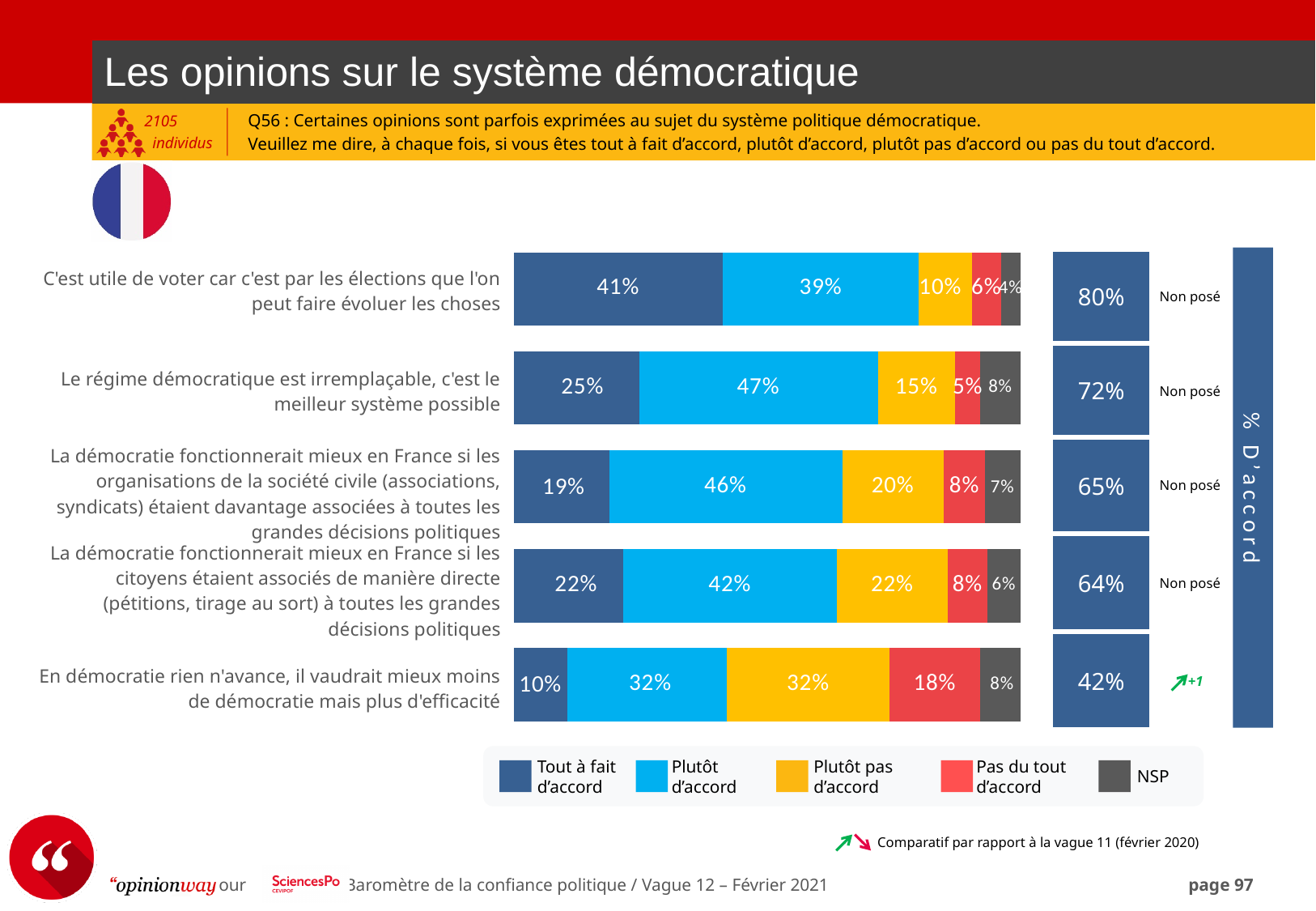
What is the combined 'Tout à fait d'accord' plus 'Plutôt d'accord' total for 'La démocratie fonctionnerait mieux en France si les organisations de la société civile...'? 65% What kind of chart is shown on the slide? Stacked bar chart How many statements (categories) are plotted in the chart? 5 Which statement has the highest '% D'accord' value? C'est utile de voter car c'est par les élections que l'on peut faire évoluer les choses What is the 'Plutôt d'accord' value for 'Le régime démocratique est irremplaçable, c'est le meilleur système possible'? 47% How many series does the legend list? 5 Which legend entry is shown in red? Pas du tout d'accord What is the 'Pas du tout d'accord' value for 'En démocratie rien n'avance, il vaudrait mieux moins de démocratie mais plus d'efficacité'? 18% What is the difference between the '% D'accord' values for 'C'est utile de voter...' (80%) and 'Le régime démocratique est irremplaçable...' (72%)? 8 points Which statement has the lowest 'Tout à fait d'accord' value? En démocratie rien n'avance, il vaudrait mieux moins de démocratie mais plus d'efficacité Which is larger: the 'Plutôt pas d'accord' value for 'La démocratie fonctionnerait mieux en France si les citoyens étaient associés de manière directe...' or for 'Le régime démocratique est irremplaçable...'? La démocratie fonctionnerait mieux en France si les citoyens étaient associés de manière directe... What is the 'Tout à fait d'accord' value for 'C'est utile de voter car c'est par les élections que l'on peut faire évoluer les choses'? 41%